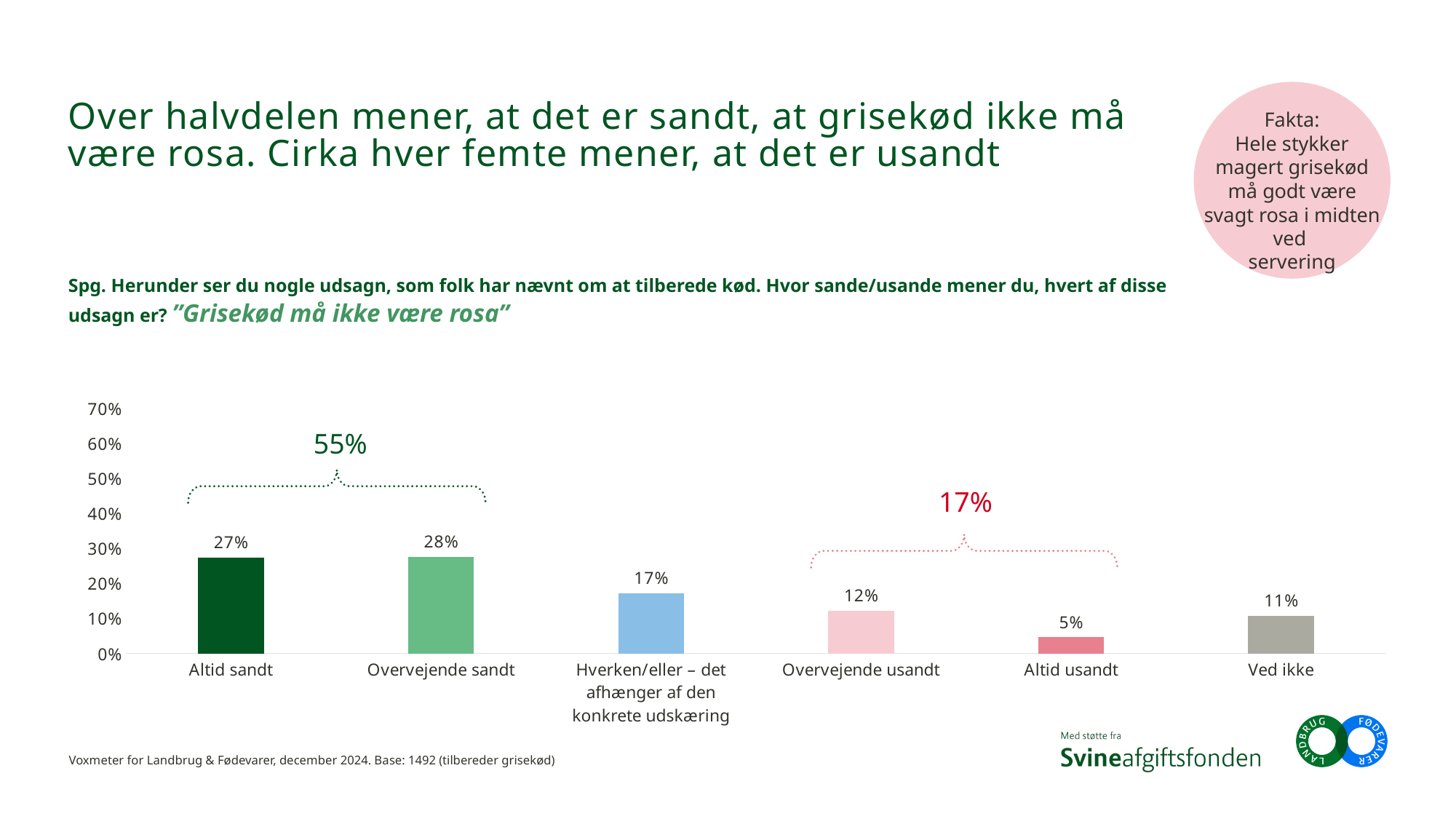
Which is larger, the value for "Ved ikke" or the value for "Overvejende usandt"? Overvejende usandt What is the value for "Overvejende sandt"? 28% What is the value for "Hverken/eller – det afhænger af den konkrete udskæring"? 17% How many categories are shown on the x axis? 6 What combined percentage is shown above the bracket spanning "Altid sandt" and "Overvejende sandt"? 55% What is the difference between the values for "Overvejende usandt" and "Altid usandt"? 7% Which category has the highest value? Overvejende sandt What is the value for "Altid sandt"? 27% What is the value for "Altid usandt"? 5% What kind of chart is shown on the slide? Bar chart What is the value for "Ved ikke"? 11% Which category has the lowest value? Altid usandt